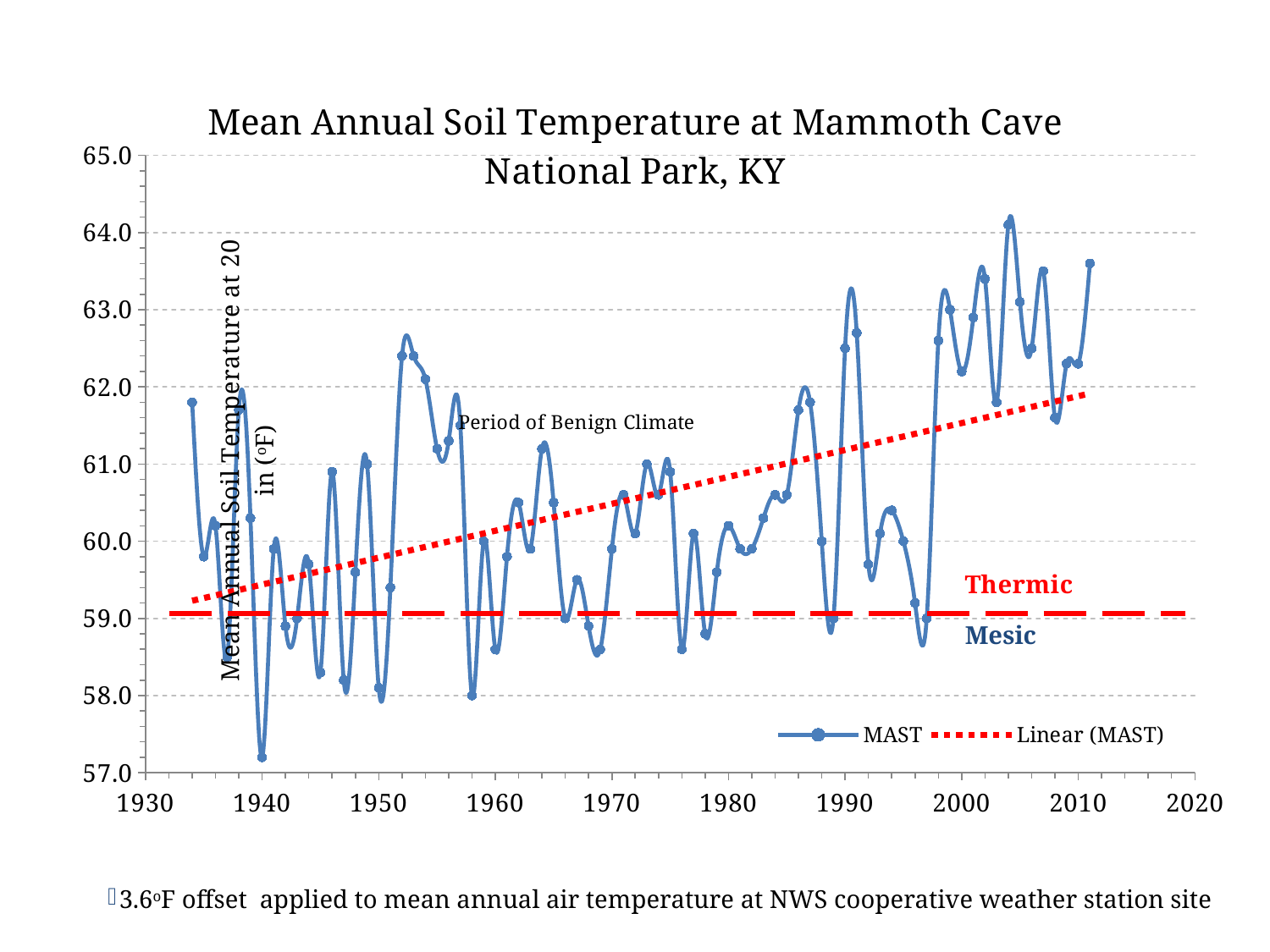
Does the Linear (MAST) trend line rise or fall from 1930 to 2010? rises In which year does the MAST series reach its lowest value? 1940 Is the lowest MAST value greater or less than 58.0? less Is the MAST value for 2000 greater or less than 61.0? greater Is the highest MAST value greater or less than 64.0? greater How many series does the legend list? 2 Which year has the larger MAST value, 1960 or 2000? 2000 Which two soil temperature regimes does the red dashed horizontal line separate? Thermic and Mesic What kind of chart is shown on the slide? line chart What is the title of the chart? Mean Annual Soil Temperature at Mammoth Cave National Park, KY